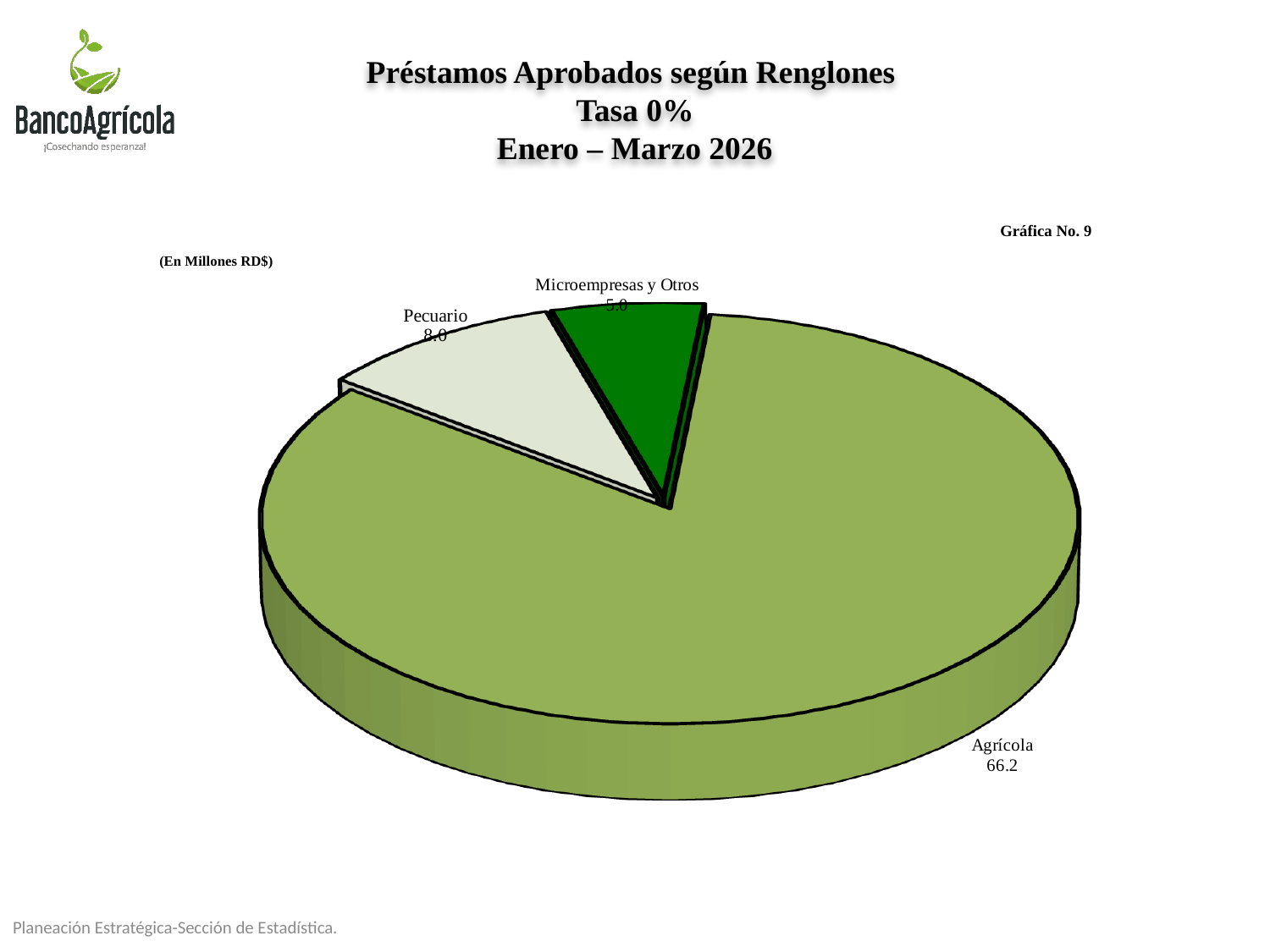
Which category has the smallest slice of the pie? Microempresas y Otros What is the value shown for Agrícola? 66.2 What is the value shown for Microempresas y Otros? 5.0 How many slices does the pie chart have? 3 What is the difference between the values for Pecuario and Microempresas y Otros? 3.0 What is the total of all the slices in the pie chart? 79.2 Which category has the largest slice of the pie? Agrícola What is the difference between the values for Agrícola and Pecuario? 58.2 What is the value shown for Pecuario? 8.0 Which is larger, the value for Pecuario or the value for Microempresas y Otros? Pecuario What kind of chart is shown on the slide? Pie chart In what units are the values of the chart expressed, according to the note on the slide? En Millones RD$